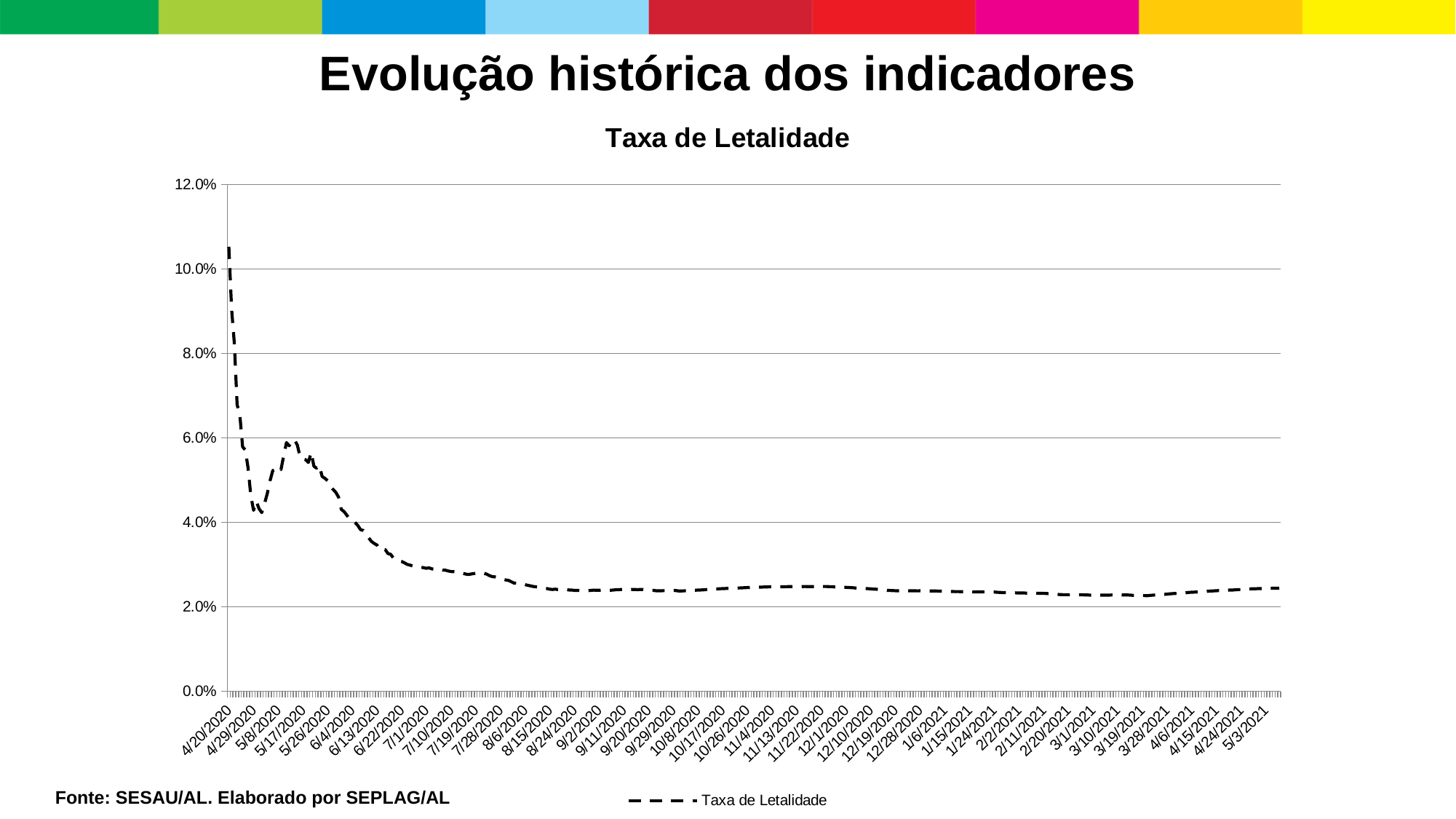
What is the name of the series shown in the legend? Taxa de Letalidade Is the value for 4/20/2020 greater or less than 10.0%? greater What is the title of the chart? Taxa de Letalidade Is the value for 5/3/2021 greater or less than 4.0%? less Is the value for 8/6/2020 greater or less than 4.0%? less Overall, does the Taxa de Letalidade rise or fall from 4/20/2020 to 5/3/2021? fall On which date is the Taxa de Letalidade highest? 4/20/2020 Which date has the larger Taxa de Letalidade, 4/20/2020 or 5/3/2021? 4/20/2020 How many series does the legend list? 1 What kind of chart is shown on the slide? line chart Which date has the larger Taxa de Letalidade, 6/4/2020 or 9/2/2020? 6/4/2020